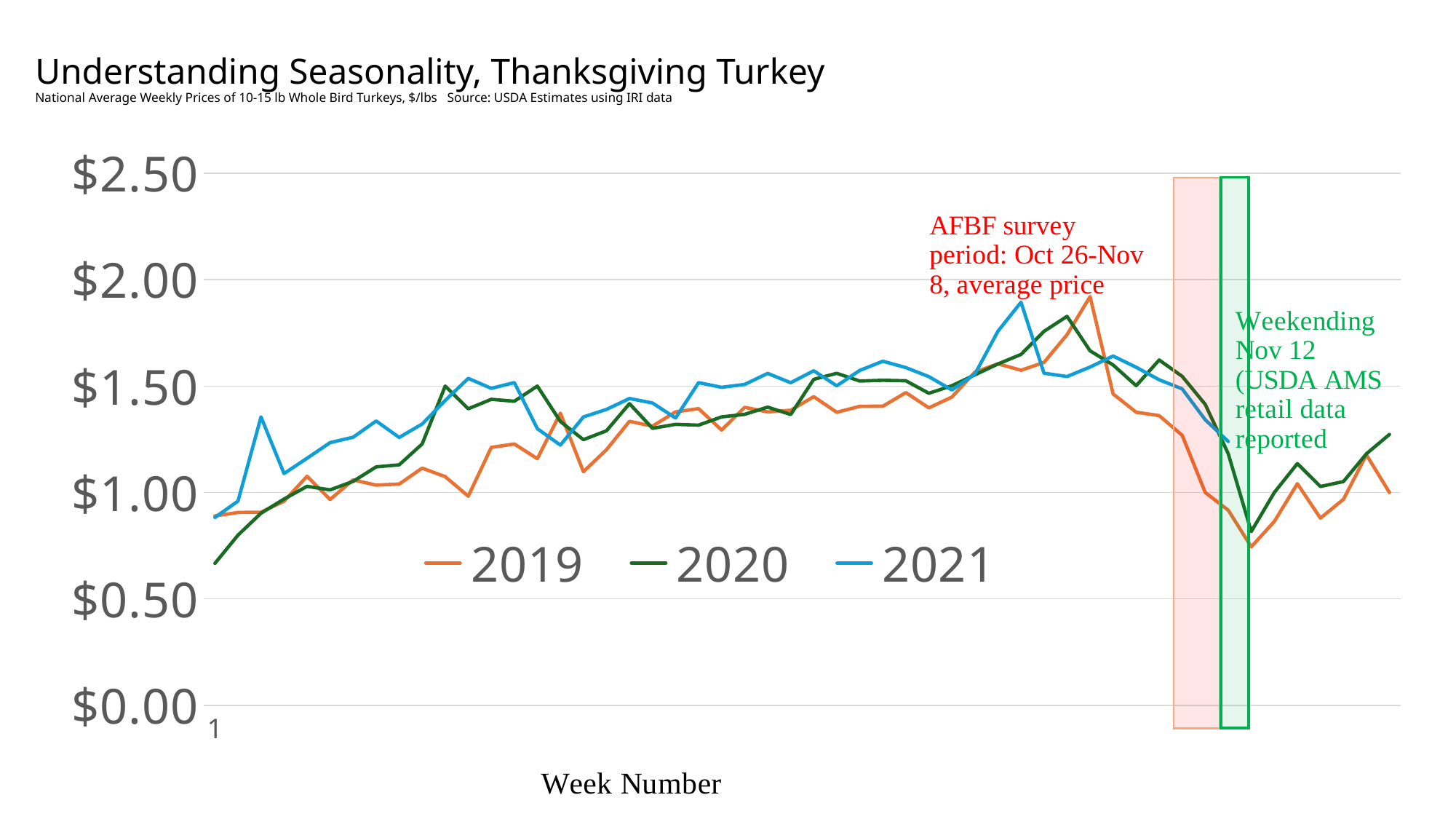
What is the label of the x axis? Week Number Is the lowest value of the 2019 line greater or less than $1.00? less At week 1, is the value for 2020 or 2021 larger? 2021 How many series does the legend list? 3 What kind of chart is shown on the slide? line chart Is the highest value of the 2021 line greater or less than $1.50? greater Is the highest value of the 2019 line greater or less than $2.00? less Over the first ten weeks, do the 2020 prices generally rise or fall? rise Which years are listed in the chart legend? 2019, 2020, 2021 In the weeks immediately after the AFBF survey period, do the 2019 prices rise or fall? fall Which series has the lowest value at week 1? 2020